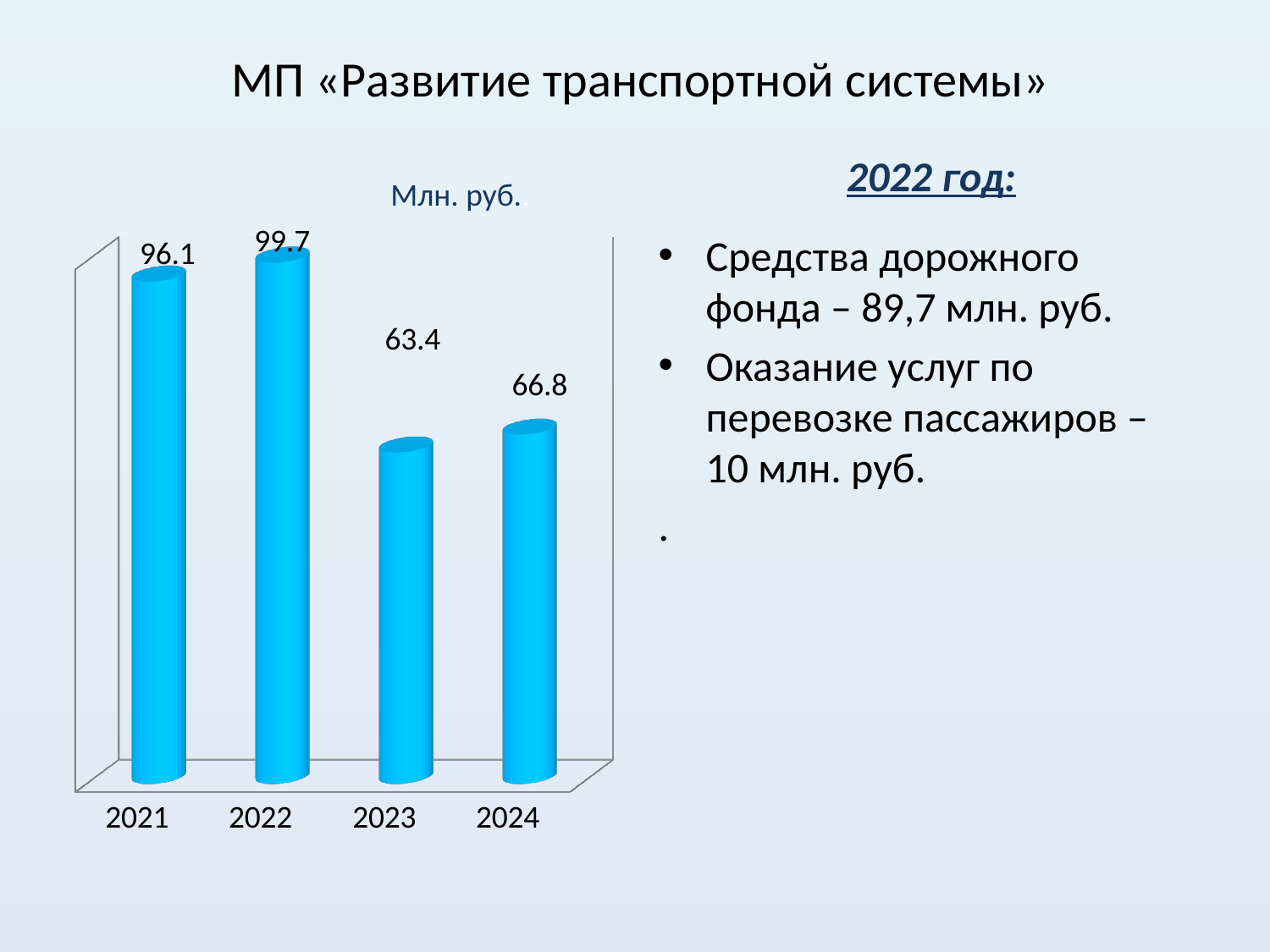
Which year has the highest value? 2022 Which year has the lowest value? 2023 Do the values rise or fall from 2022 to 2023? fall What kind of chart is shown on the slide? bar chart Which is larger, the value for 2021 or the value for 2024? 2021 How many years are shown on the chart? 4 What is the difference between the values for 2024 and 2023? 3.4 What is the difference between the values for 2022 and 2021? 3.6 What unit is shown above the chart? Млн. руб. What is the value for 2023? 63.4 What is the value for 2024? 66.8 What is the value for 2021? 96.1